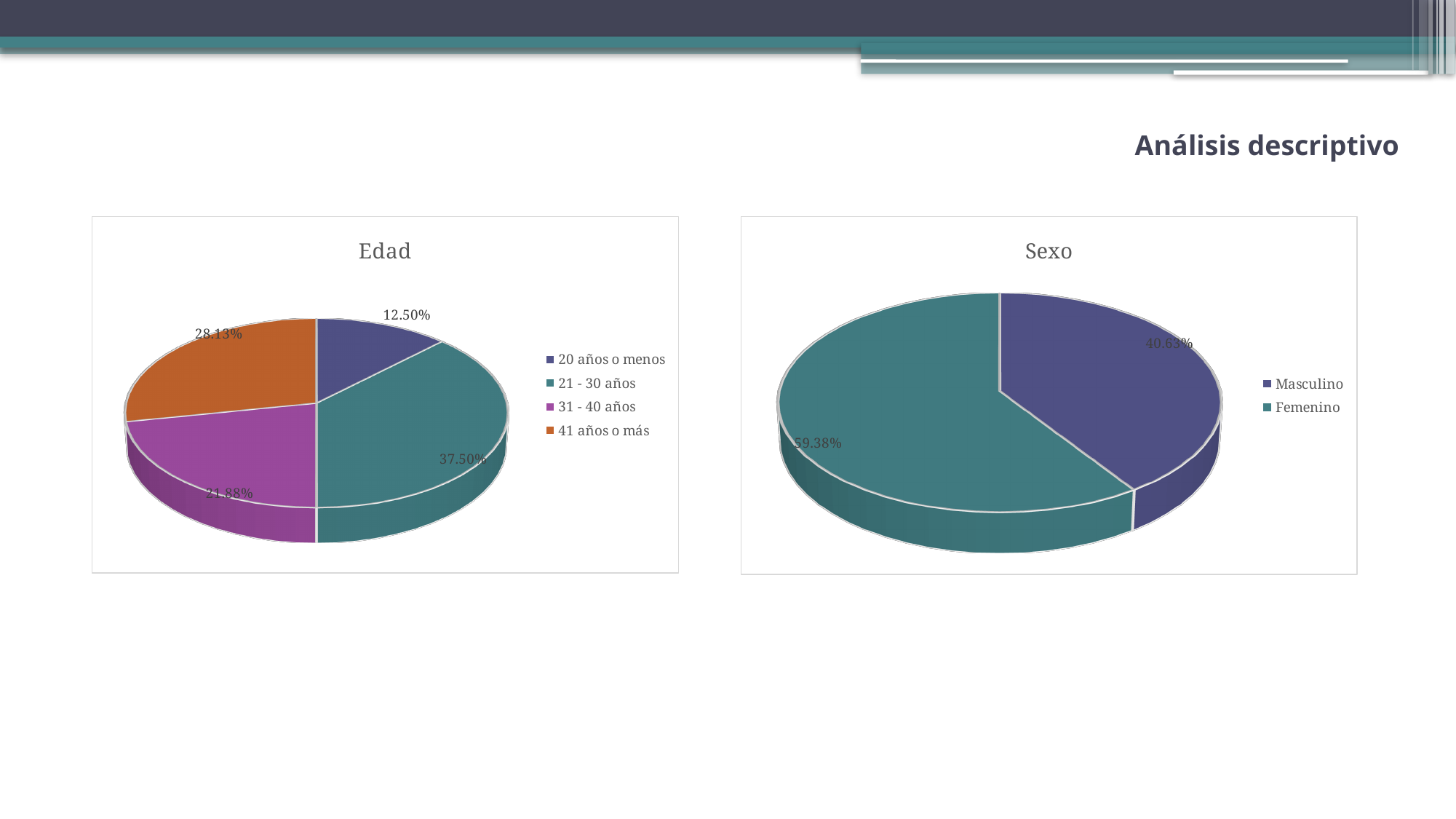
In the 'Edad' chart, how many age categories does the legend list? 4 In the 'Edad' chart, what percentage is shown for '21 - 30 años'? 37.50% In the 'Edad' chart, what colour is the '41 años o más' slice? Orange In the 'Sexo' chart, which category is larger, 'Masculino' or 'Femenino'? Femenino What kind of chart is the 'Sexo' chart? Pie chart In the 'Sexo' chart, what percentage is shown for 'Femenino'? 59.38% In the 'Edad' chart, what percentage is shown for '20 años o menos'? 12.50% In the 'Edad' chart, what percentage is shown for '41 años o más'? 28.13% In the 'Edad' chart, which age group has the largest share? 21 - 30 años In the 'Sexo' chart, what percentage is shown for 'Masculino'? 40.63% In the 'Edad' chart, which age group has the smallest share? 20 años o menos In the 'Edad' chart, what is the difference between the shares of '41 años o más' and '31 - 40 años'? 6.25%